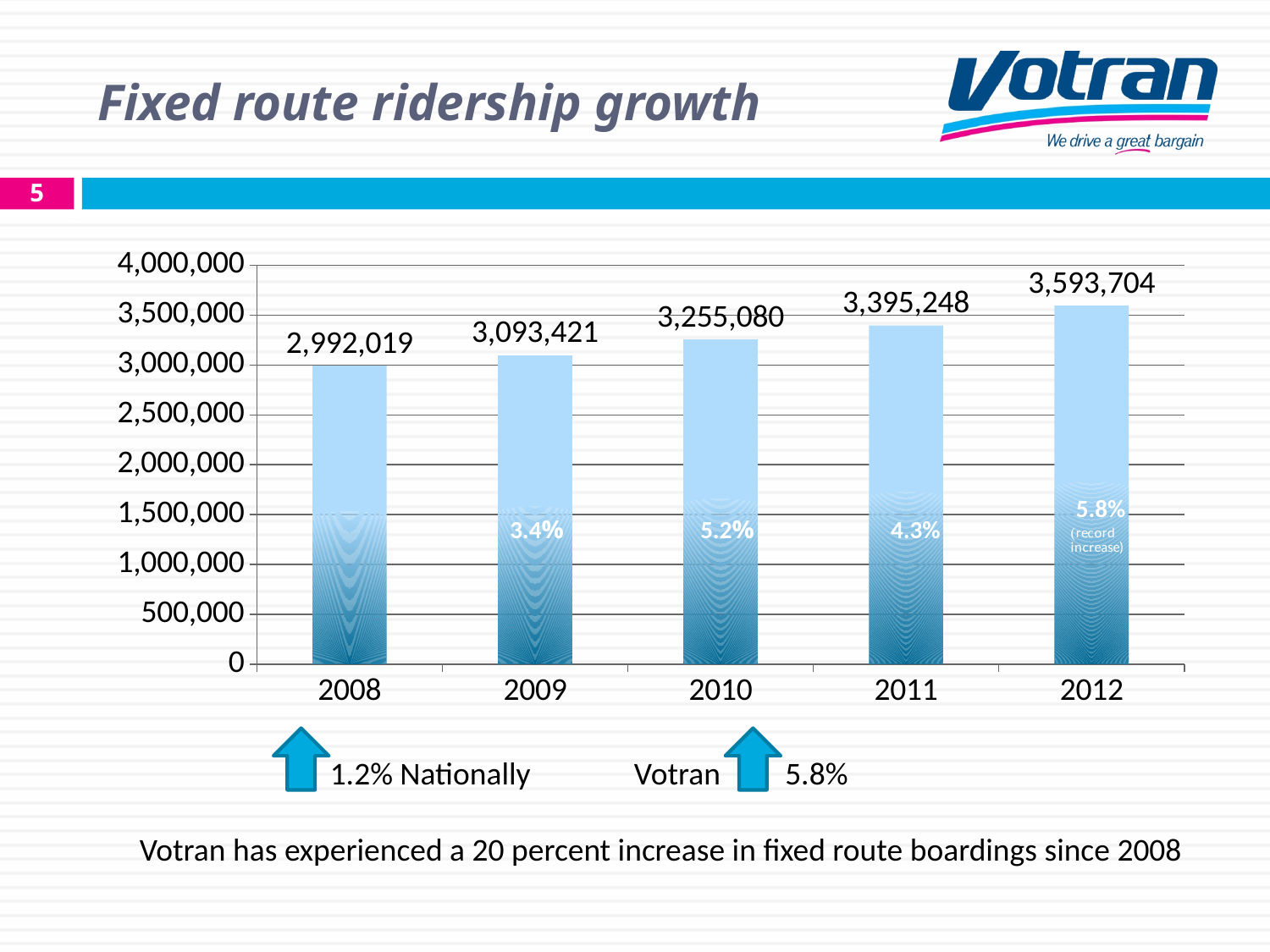
What is the difference in ridership between 2012 and 2008? 601,685 Which year has the lowest ridership? 2008 What is the fixed route ridership value for 2010? 3,255,080 Do the ridership values rise or fall from 2008 to 2012? Rise Which year has higher ridership, 2009 or 2011? 2011 What is the fixed route ridership value for 2008? 2,992,019 What kind of chart is shown on the slide? Bar chart What is the difference in ridership between 2011 and 2010? 140,168 How many years are shown on the x axis? 5 Which year has the highest ridership? 2012 Is the ridership value for 2009 greater or less than 3,000,000? greater What is the fixed route ridership value for 2012? 3,593,704